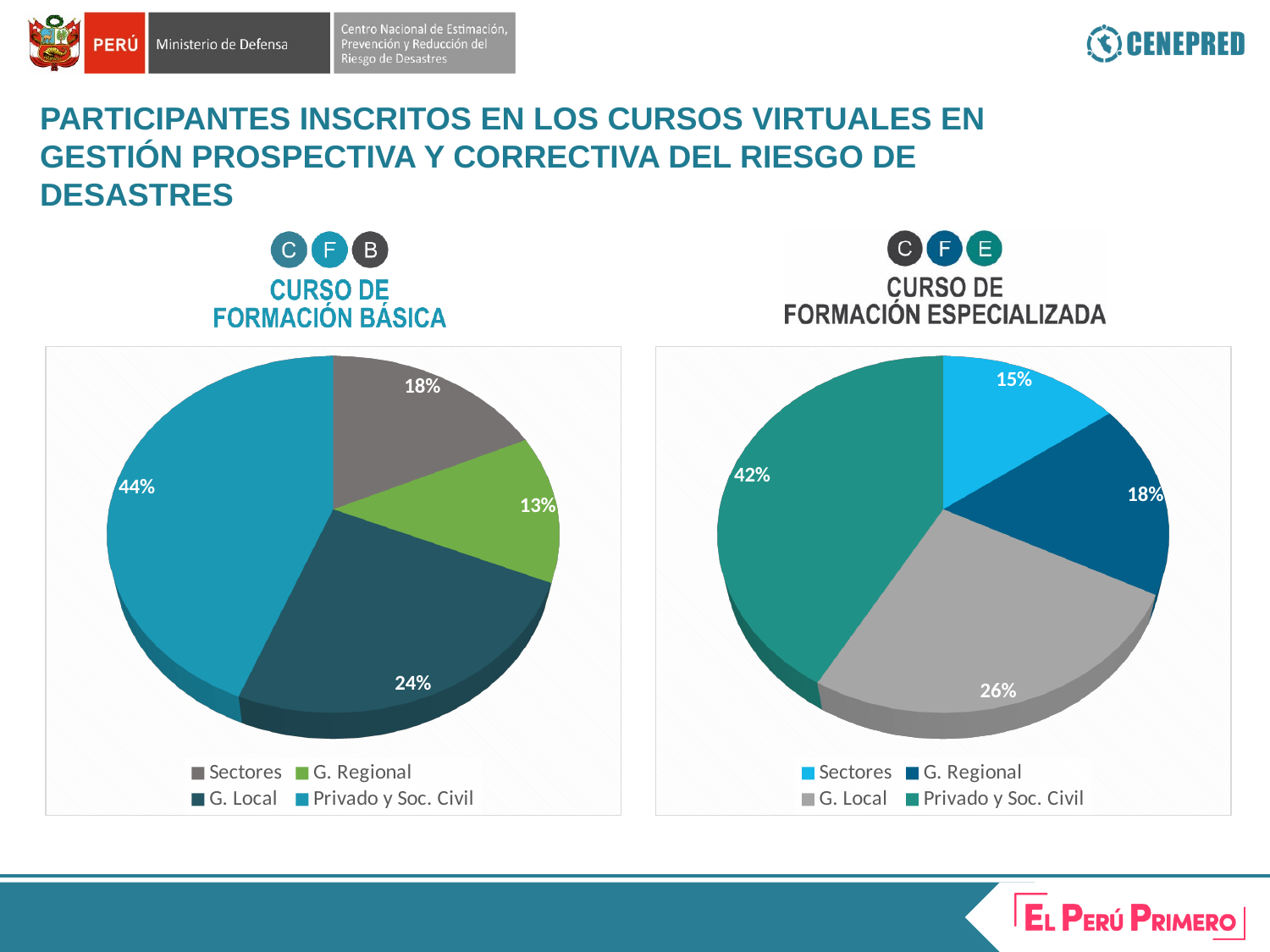
In the Curso de Formación Especializada pie chart, what is the difference between the shares for Privado y Soc. Civil and G. Local? 16% How many categories does the legend of the Curso de Formación Especializada pie chart list? 4 In the Curso de Formación Básica pie chart, which category has the smallest slice? G. Regional In the Curso de Formación Básica pie chart, what share is labelled for G. Regional? 13% In the Curso de Formación Básica pie chart, what is the combined share of Sectores and G. Regional? 31% In the Curso de Formación Básica pie chart, what share is labelled for Privado y Soc. Civil? 44% What kind of chart is used for the Curso de Formación Básica data? Pie chart In the Curso de Formación Básica pie chart, which category has the largest slice? Privado y Soc. Civil In the Curso de Formación Básica pie chart, which is larger: the share for G. Local or the share for Sectores? G. Local In the Curso de Formación Especializada pie chart, what share is labelled for G. Local? 26% In the Curso de Formación Especializada pie chart, which category has the smallest slice? Sectores In the Curso de Formación Especializada pie chart, what share is labelled for Sectores? 15%